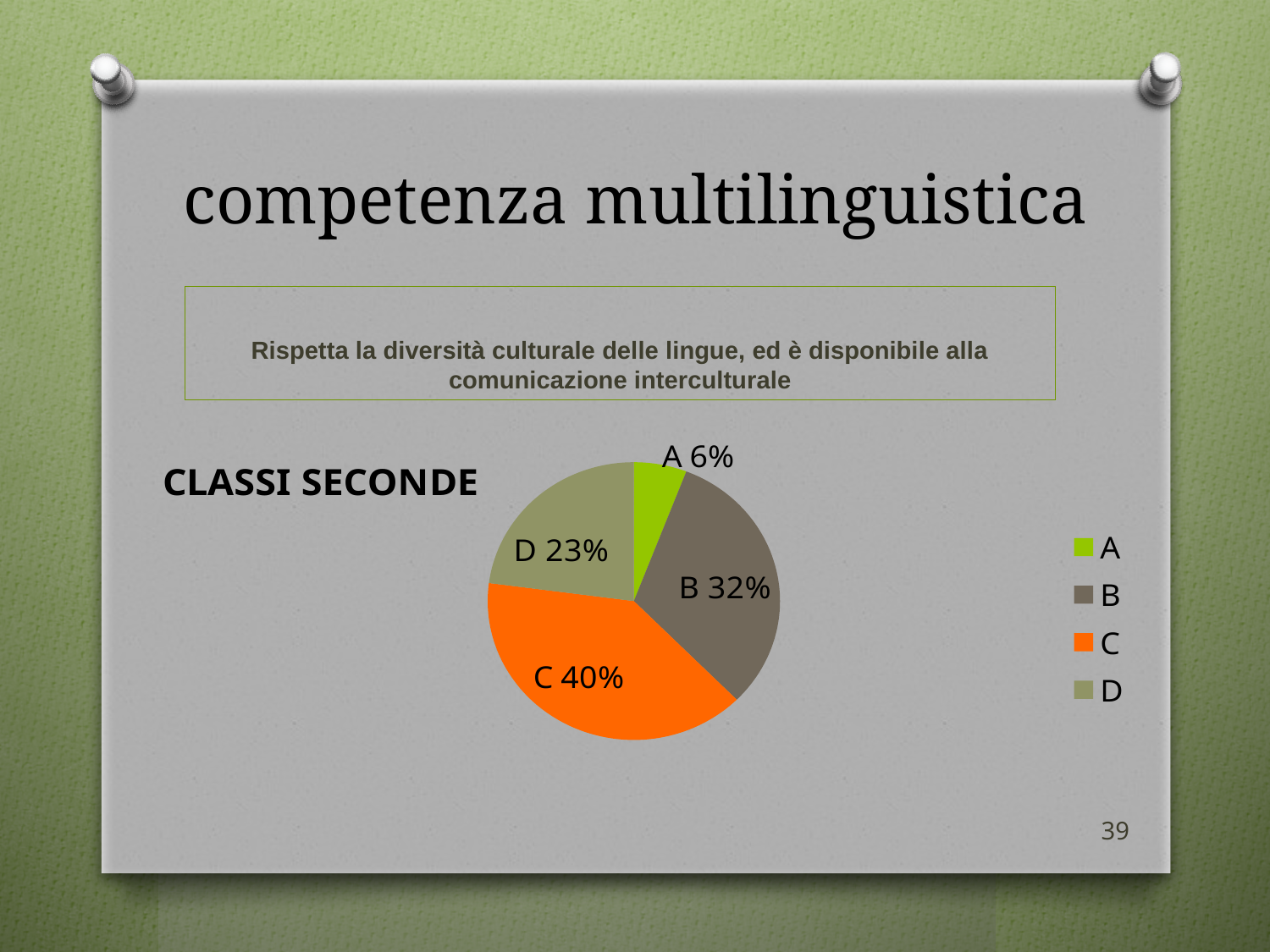
Which slice of the pie chart is the smallest? A How many entries does the legend list? 4 How many slices does the pie chart have? 4 Which is larger, slice B or slice D? B What kind of chart is shown on the slide? pie chart What colour is slice C in the pie chart? orange What percentage does slice B represent in the pie chart? 32% What percentage does slice D represent in the pie chart? 23% What percentage does slice C represent in the pie chart? 40% What percentage does slice A represent in the pie chart? 6% What is the difference in percentage points between slice C and slice B? 8 Which slice of the pie chart is the largest? C